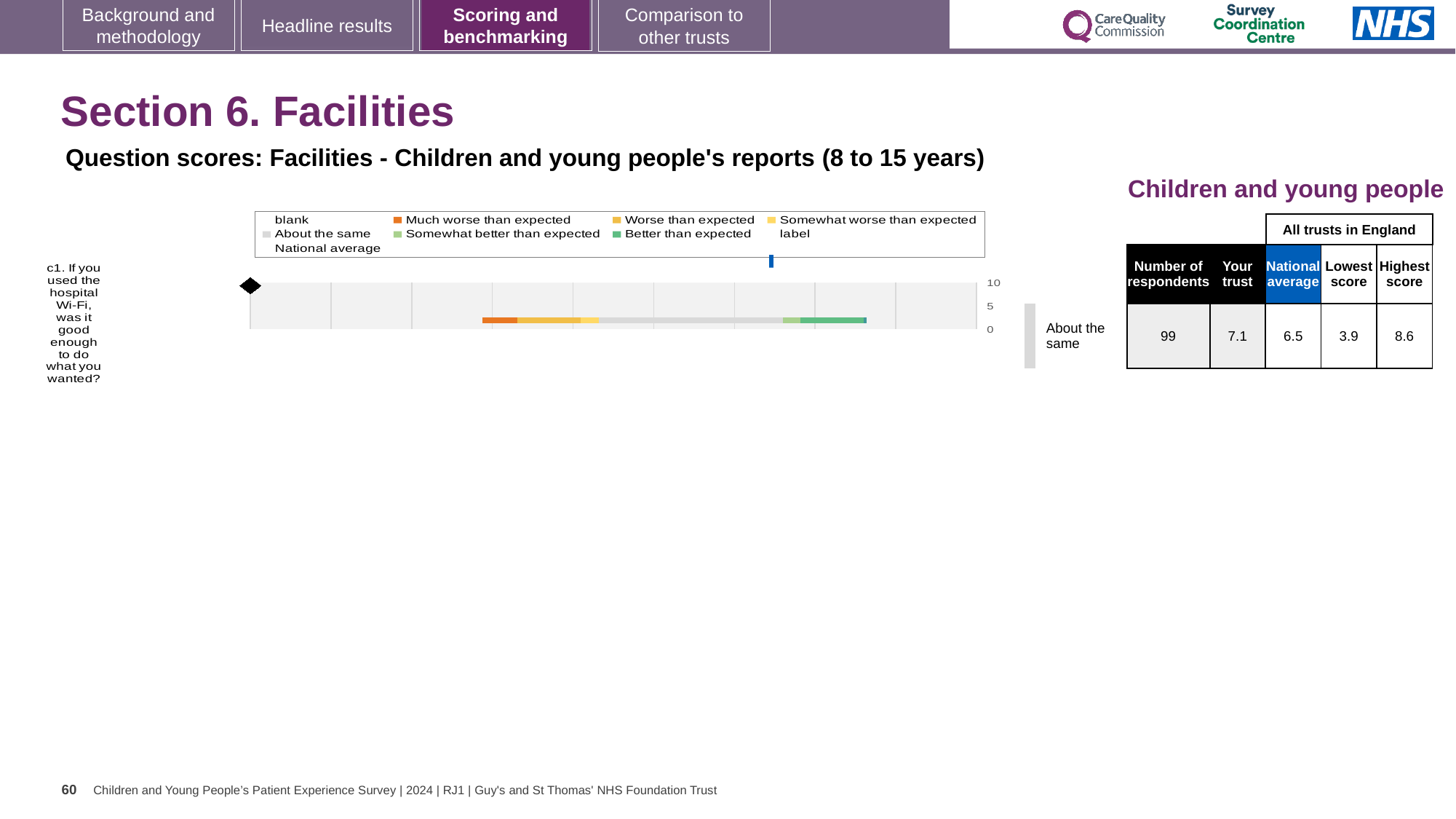
How many respondents answered question c1 according to the table beside the chart? 99 How many survey questions are plotted in the chart on this slide? 1 By how much does the 'Your trust' score (7.1) exceed the national average (6.5) for question c1? 0.6 For question c1, which is larger: the 'Your trust' score or the national average? Your trust What is the difference between the highest score (8.6) and the lowest score (3.9) for question c1? 4.7 What is the lowest score across all trusts in England for question c1? 3.9 What is the highest value shown on the chart's score axis? 10 What is the 'Your trust' score for question c1 (hospital Wi-Fi) shown in the table beside the chart? 7.1 What kind of chart is used to show the question score for c1 on this slide? Bar chart What is the national average score for question c1 shown in the table beside the chart? 6.5 What is the highest score across all trusts in England for question c1? 8.6 Which benchmark category is question c1 assigned to, according to the label beside the chart? About the same